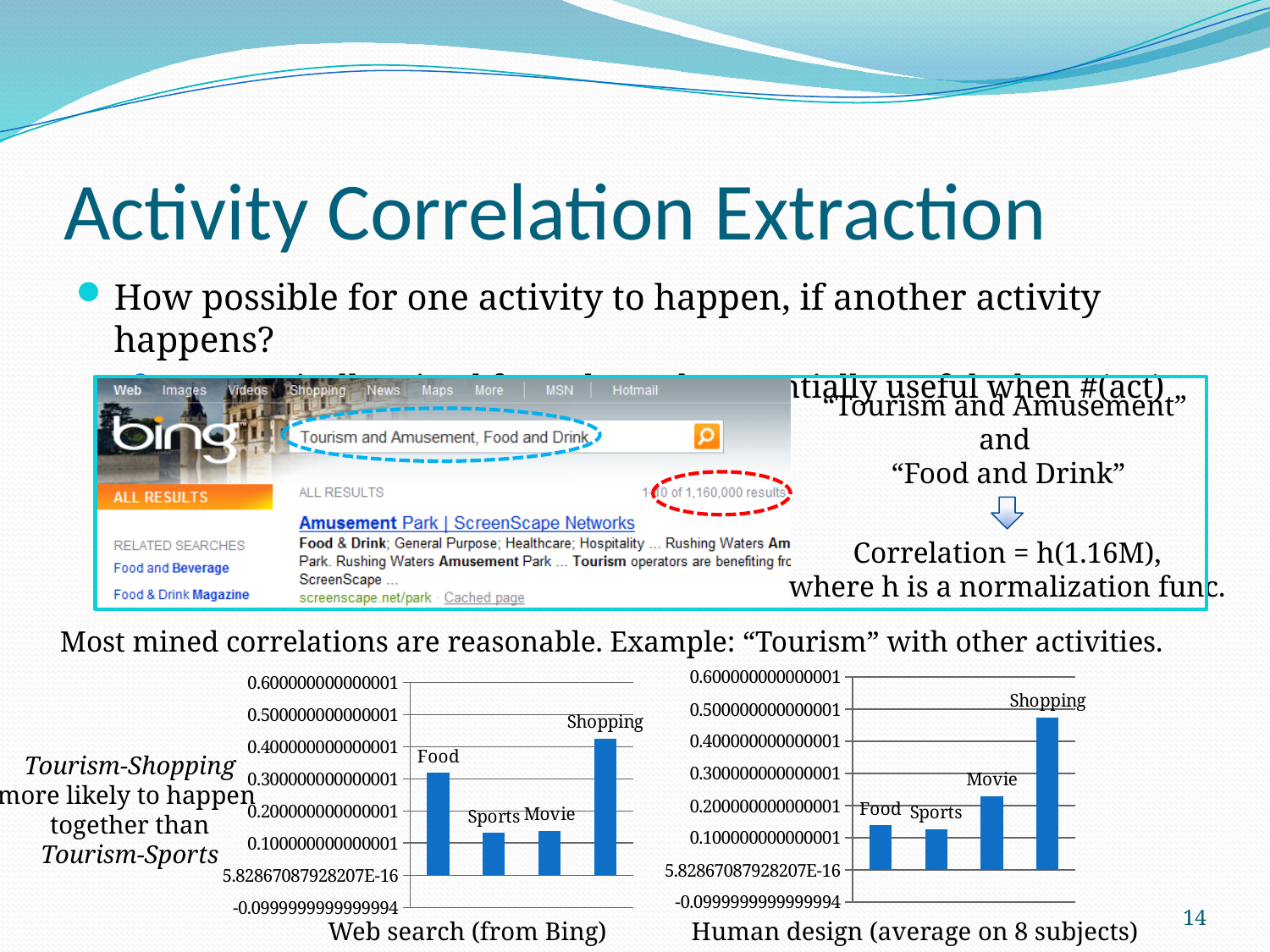
In the 'Web search (from Bing)' chart, is the value for Food greater or less than 0.4? less In the 'Human design (average on 8 subjects)' chart, which is larger, the value for Movie or the value for Food? Movie In the 'Web search (from Bing)' chart, which is larger, the value for Food or the value for Sports? Food How many activity bars are shown in the 'Human design (average on 8 subjects)' chart? 4 In the 'Web search (from Bing)' chart, which activity has the highest bar? Shopping In the 'Web search (from Bing)' chart, is the value for Sports greater or less than 0.2? less In the 'Human design (average on 8 subjects)' chart, is the value for Movie greater or less than 0.3? less What kind of chart is the 'Web search (from Bing)' chart? bar chart In the 'Human design (average on 8 subjects)' chart, which activity has the highest bar? Shopping How many activity bars are shown in the 'Web search (from Bing)' chart? 4